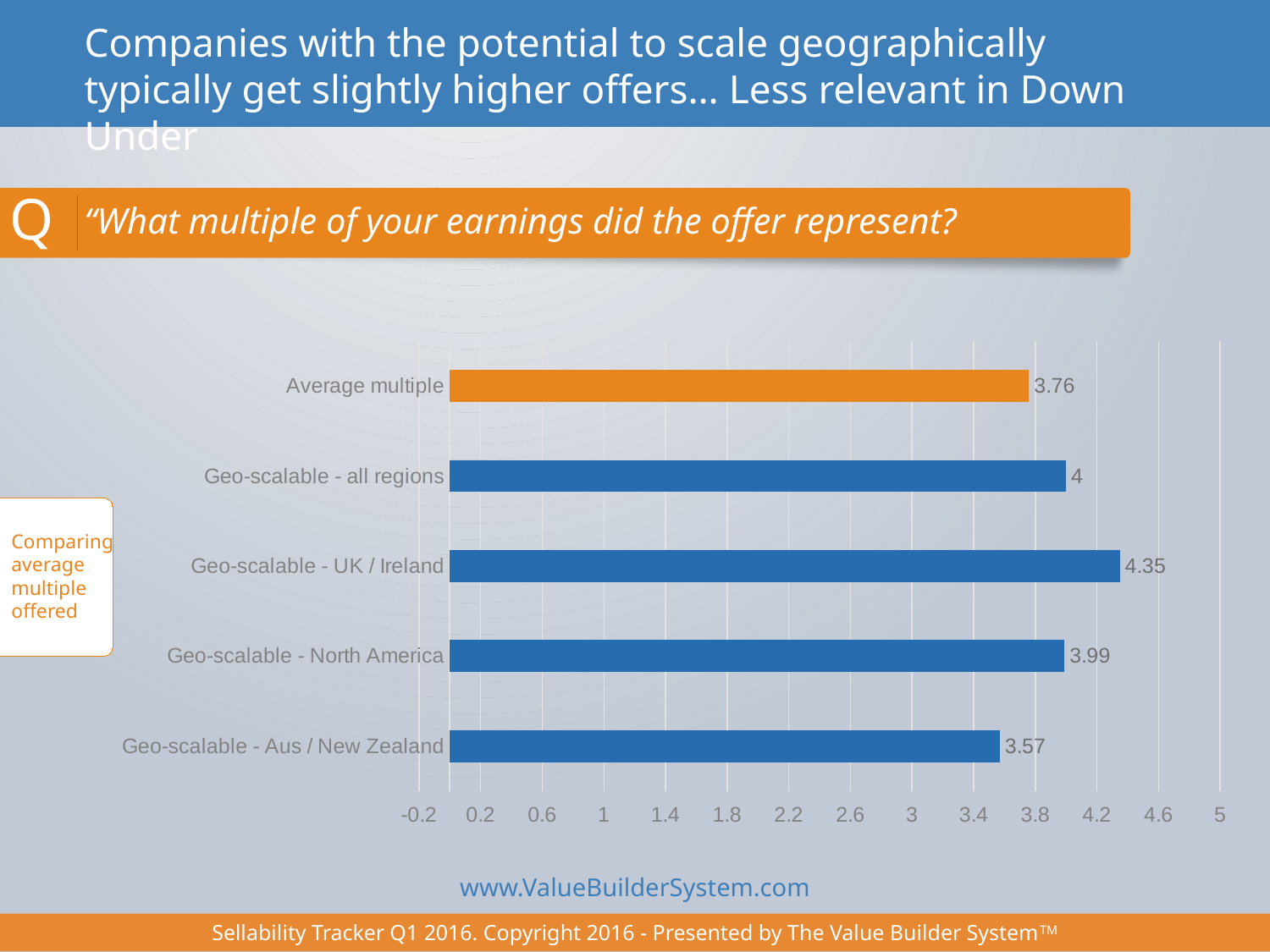
Which category has the lowest value? Geo-scalable - Aus / New Zealand What is the difference between the values for Geo-scalable - UK / Ireland and Geo-scalable - Aus / New Zealand? 0.78 How many categories are shown in the chart? 5 What kind of chart is shown on the slide? Bar chart What is the value for Geo-scalable - North America? 3.99 What is the value for Geo-scalable - UK / Ireland? 4.35 What is the value for Average multiple? 3.76 Is the value for Geo-scalable - North America greater or less than 3.8? greater What is the value for Geo-scalable - Aus / New Zealand? 3.57 Which category has the highest value? Geo-scalable - UK / Ireland Which bar is coloured orange rather than blue? Average multiple Which is larger, the value for Geo-scalable - all regions or the value for Average multiple? Geo-scalable - all regions